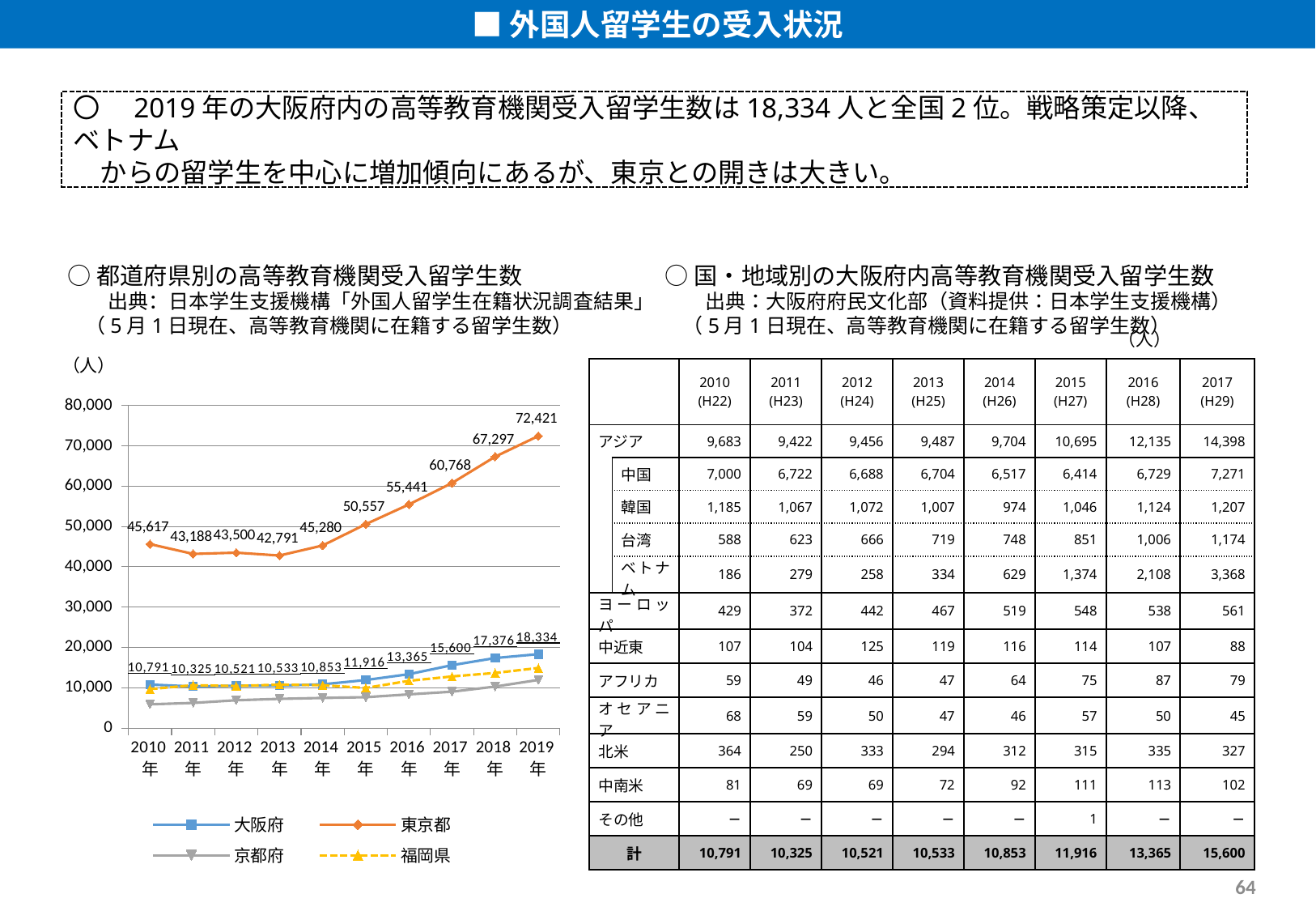
In the line chart, what is the value for 大阪府 in 2019年? 18,334 In the line chart, what is the difference between 東京都 and 大阪府 in 2019年? 54,087 In the line chart, what is the value for 東京都 in 2013年? 42,791 How many series does the legend of the line chart list? 4 In the line chart, which prefecture has the highest value in 2019年? 東京都 In the line chart, how many years are shown on the x axis? 10 In the line chart, which prefecture has the lowest value in 2010年? 京都府 In the line chart, does the value for 東京都 rise or fall from 2014年 to 2019年? rise In the line chart, what is the value for 大阪府 in 2010年? 10,791 In the line chart, is the value for 京都府 in 2010年 greater or less than 10,000? less What type of chart is shown on the left of the slide? line chart In the line chart, what is the value for 東京都 in 2019年? 72,421